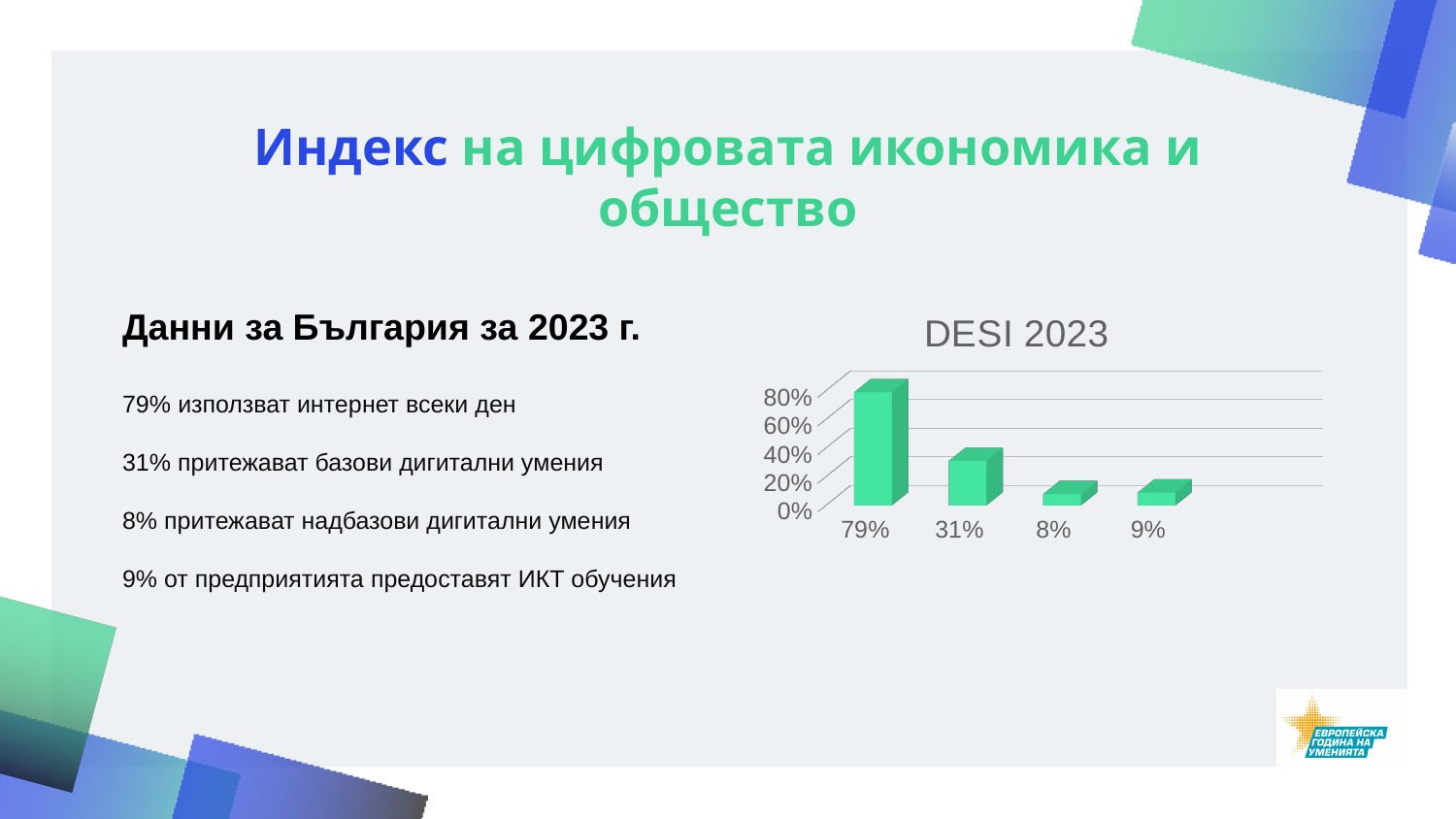
Which bar in the DESI 2023 chart is the shortest? 8% What is the title of the chart on the slide? DESI 2023 Which bar in the DESI 2023 chart is the tallest? 79% Do the bars in the DESI 2023 chart generally rise or fall from left to right? fall What is the difference between the first bar (79%) and the second bar (31%) in the DESI 2023 chart? 48% In the DESI 2023 chart, is the last bar (labelled 9%) greater or less than 20%? less In the DESI 2023 chart, is the first bar (labelled 79%) greater or less than 60%? greater What is the highest value shown on the vertical axis of the DESI 2023 chart? 80% In the DESI 2023 chart, which is larger: the first bar (79%) or the second bar (31%)? 79% What kind of chart is shown under the title DESI 2023? bar chart How many bars does the DESI 2023 chart show? 4 In the DESI 2023 chart, is the second bar (labelled 31%) greater or less than 40%? less